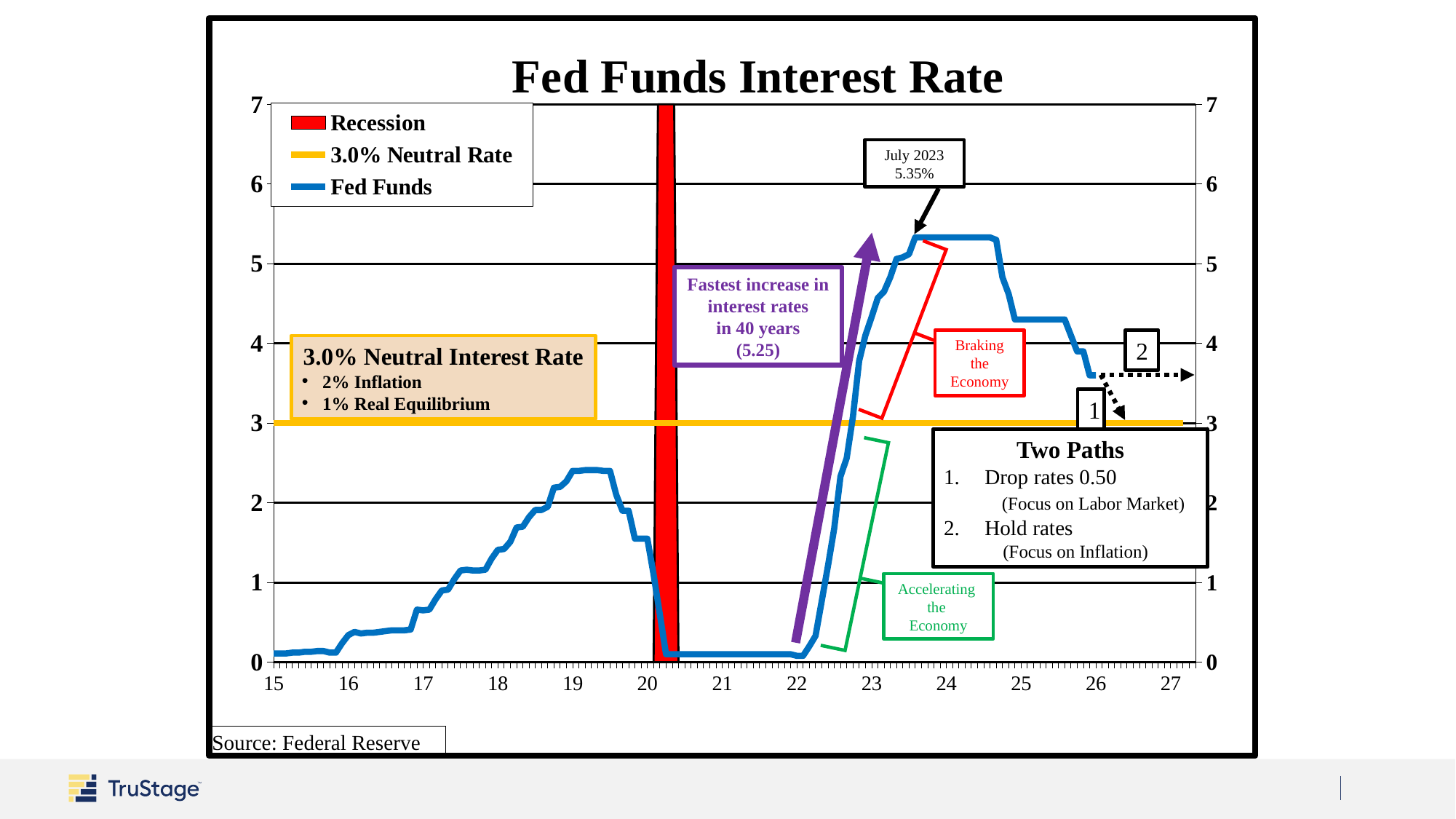
How many entries does the chart legend list? 3 What Fed Funds rate is labelled for July 2023? 5.35% Does the Fed Funds line rise or fall between 2022 and 2023? rise Which is higher, the Fed Funds rate in 2019 or in 2024? 2024 Is the Fed Funds rate at the start of 2024 greater or less than 5? greater What kind of chart is used to show the Fed Funds rate? line chart Is the Fed Funds rate in 2019 greater or less than 3? less What is the title of the chart? Fed Funds Interest Rate Is the Fed Funds rate in 2021 greater or less than 1? less What value is the neutral interest rate line drawn at? 3.0% What colour is the Fed Funds line? blue Does the Fed Funds line rise or fall between mid-2024 and 2026? fall